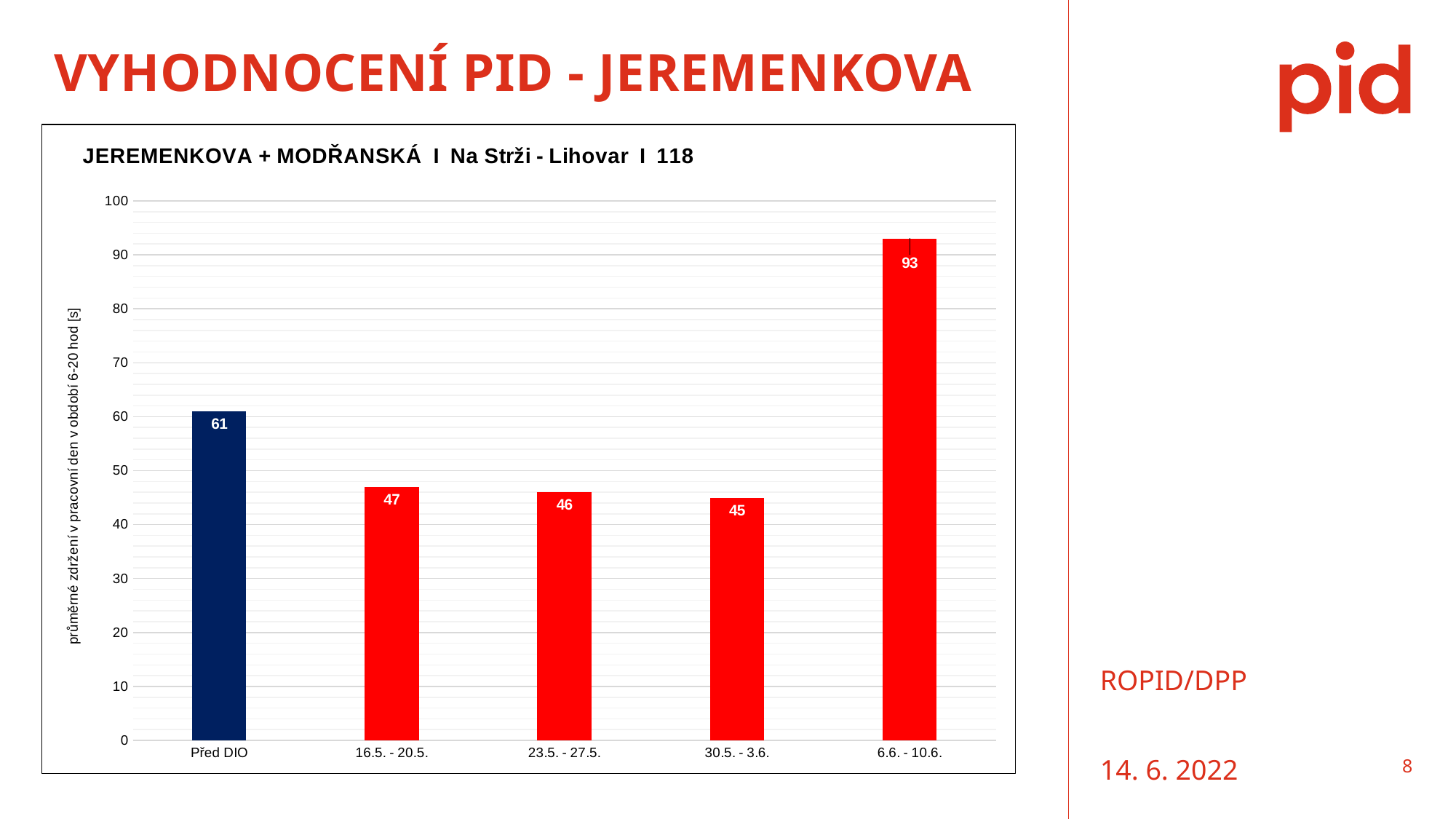
What is the difference between the values for 6.6. - 10.6. and Před DIO? 32 Which bar is coloured dark blue rather than red? Před DIO What is the value for Před DIO? 61 What kind of chart is shown on the slide? bar chart What is the title of the chart? JEREMENKOVA + MODŘANSKÁ I Na Strži - Lihovar I 118 Which is larger, the value for 16.5. - 20.5. or the value for 30.5. - 3.6.? 16.5. - 20.5. What is the value for 23.5. - 27.5.? 46 Which category has the lowest value? 30.5. - 3.6. How many categories are shown on the x axis? 5 What is the value for 6.6. - 10.6.? 93 Is the value for 6.6. - 10.6. greater or less than 90? greater Which category has the highest value? 6.6. - 10.6.